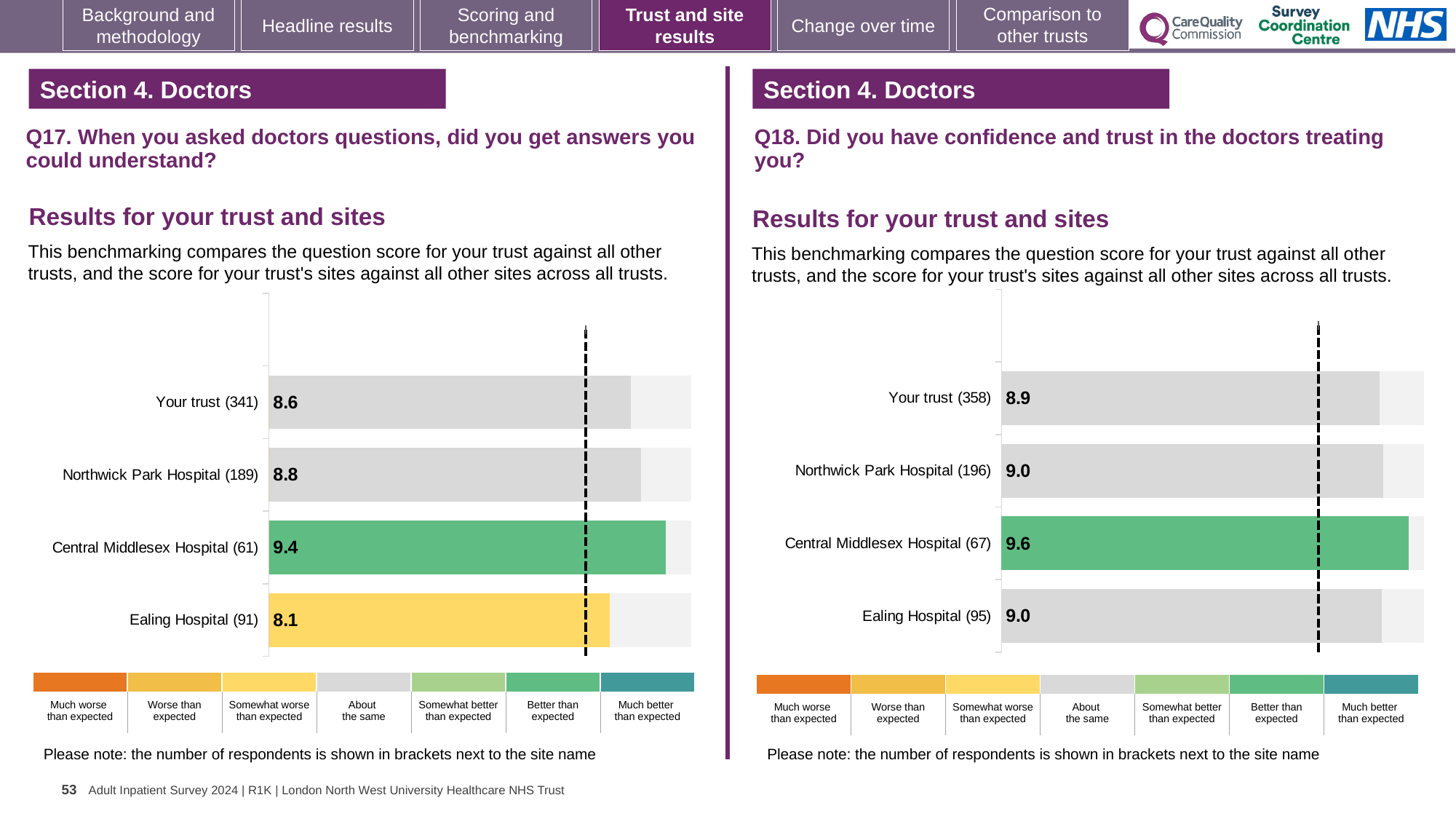
On the Q18 chart (right), what is the score for Your trust? 8.9 How many bars are shown on the Q18 chart (right)? 4 On the Q17 chart (left), what is the difference between the scores for Central Middlesex Hospital and Ealing Hospital? 1.3 On the Q17 chart (left), which site has the lowest score? Ealing Hospital On the Q18 chart (right), which site has the highest score? Central Middlesex Hospital On the Q17 chart (left), what is the score for Central Middlesex Hospital? 9.4 On the Q17 chart (left), which benchmark category does the colour of the Ealing Hospital bar correspond to? Somewhat worse than expected On the Q18 chart (right), what is the difference between the scores for Central Middlesex Hospital and Your trust? 0.7 On the Q17 chart (left), what is the score for Ealing Hospital? 8.1 On the Q17 chart (left), which has the higher score, Your trust or Northwick Park Hospital? Northwick Park Hospital What type of chart is used for the Q17 results (left)? Bar chart On the Q18 chart (right), what is the score for Northwick Park Hospital? 9.0